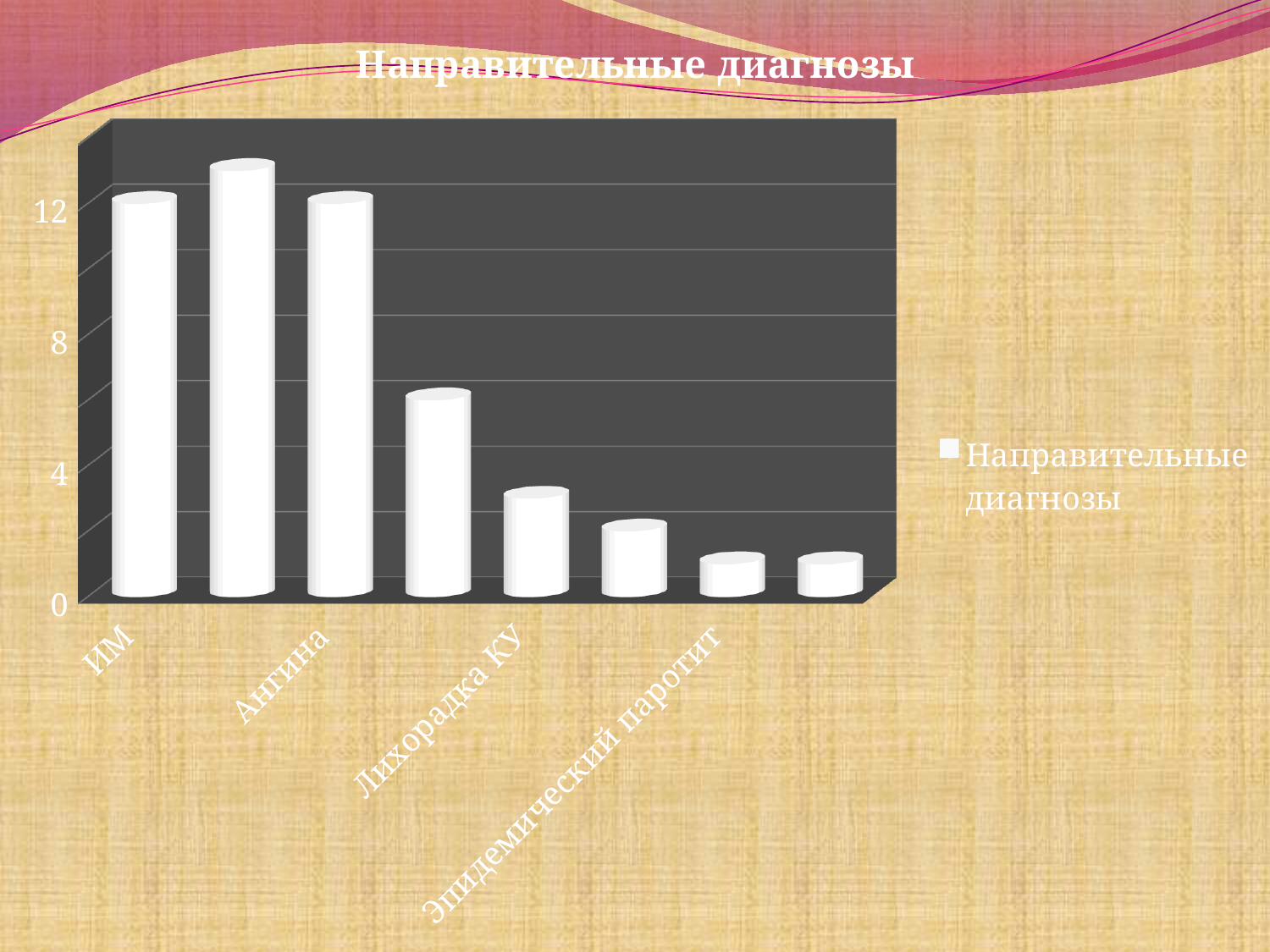
Which is larger, the value for Лихорадка КУ or the value for Эпидемический паротит? Лихорадка КУ How many series does the legend list? 1 Do the bar values generally rise or fall from left to right along the x axis? fall Is the value for Эпидемический паротит greater or less than 4? less Is the value for Лихорадка КУ greater or less than 4? less What entry is shown in the chart's legend? Направительные диагнозы What kind of chart is shown on the slide? bar chart What is the title of the chart? Направительные диагнозы Which is larger, the value for Ангина or the value for Лихорадка КУ? Ангина Is the value for ИМ greater or less than 8? greater How many bars does the chart contain? 8